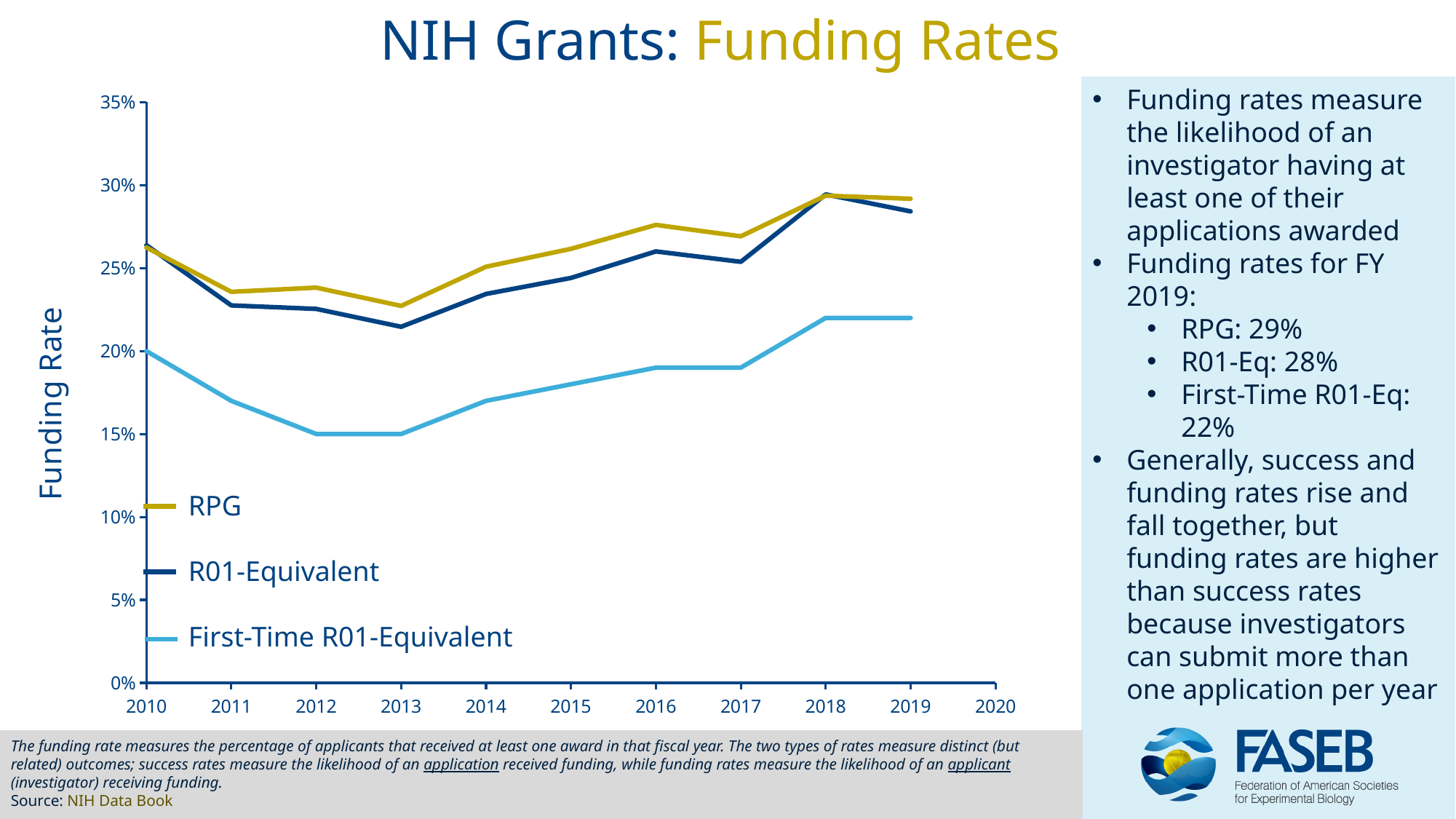
What is the difference between the RPG and First-Time R01-Equivalent funding rates in FY 2019? 7% How many years of data are plotted for each series in the chart? 10 Does the First-Time R01-Equivalent funding rate rise or fall from 2013 to 2019? rise What is the First-Time R01-Equivalent funding rate in 2010? 20% How many series does the chart's legend list? 3 What is the First-Time R01-Equivalent funding rate for FY 2019? 22% What is the RPG funding rate for FY 2019? 29% Which series has the higher funding rate in 2019, RPG or R01-Equivalent? RPG Is the RPG funding rate in 2018 greater or less than 25%? greater What kind of chart is shown on the slide? line chart What is the R01-Equivalent funding rate for FY 2019? 28% Which series has the lowest funding rate across all years shown? First-Time R01-Equivalent